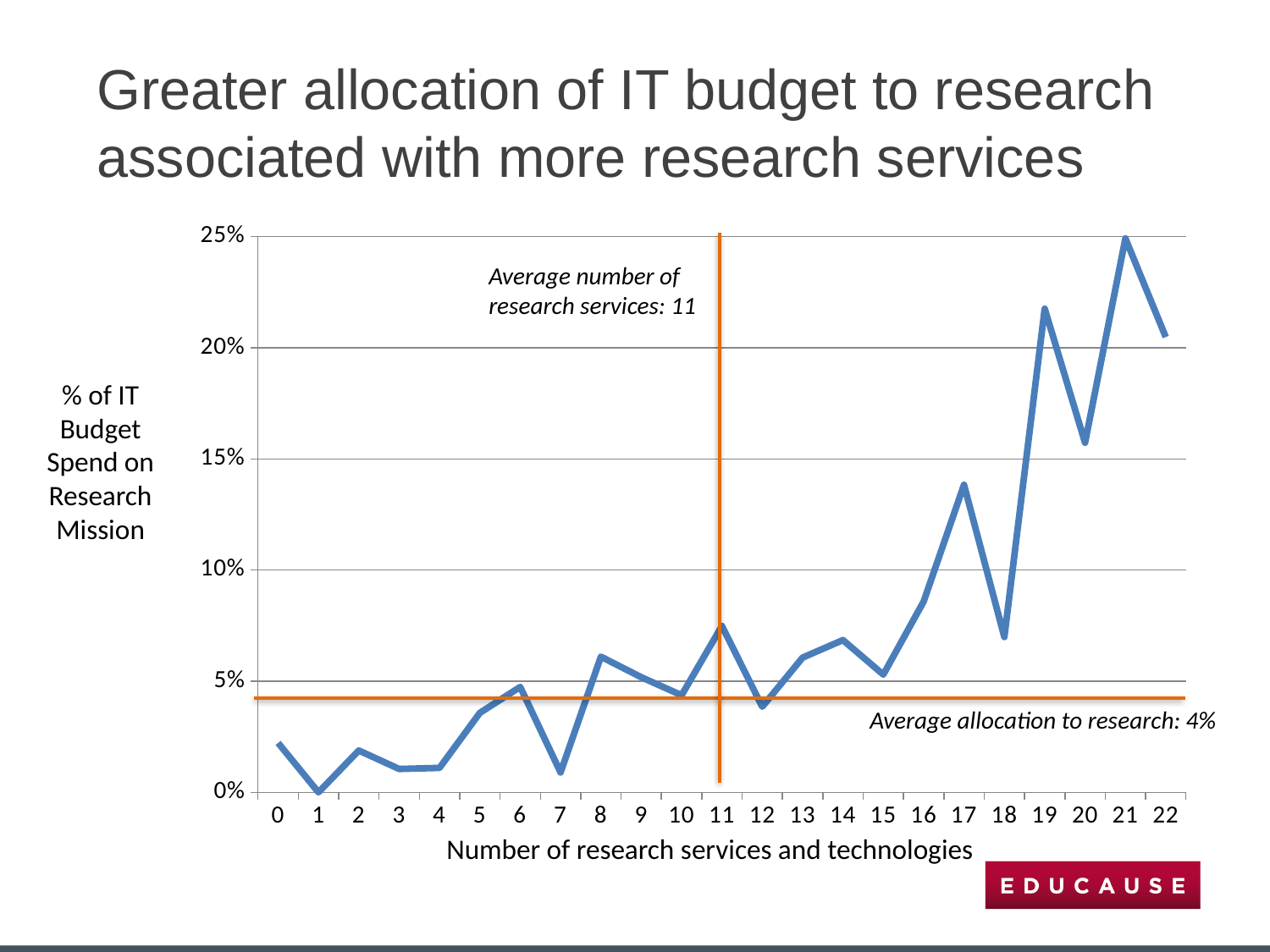
At which number of research services and technologies is the % of IT budget spend on research mission lowest? 1 What is the % of IT budget spend on research mission at 1 research service? 0% Is the value at 18 research services greater or less than 10%? less Which has a higher % of IT budget spend on research mission: 17 or 18 research services? 17 Overall, does the % of IT budget spend on research mission rise or fall as the number of research services increases? rise Is the value at 17 research services greater or less than 10%? greater How many data points are plotted along the x axis? 23 Is the value at 7 research services greater or less than 5%? less According to the annotation on the chart, what is the average number of research services? 11 At which number of research services and technologies is the % of IT budget spend on research mission highest? 21 What kind of chart is shown on the slide? line chart